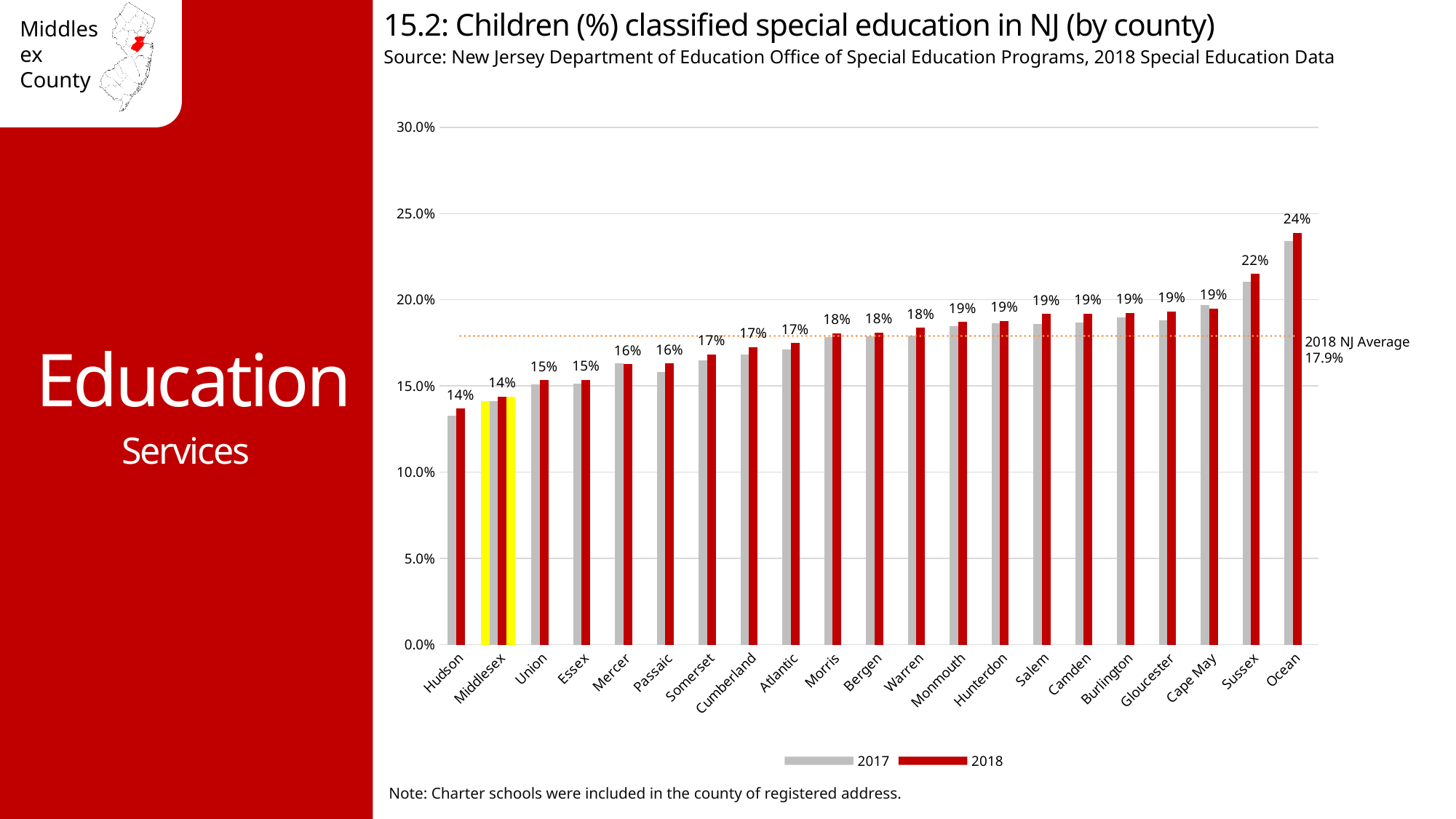
Which has the larger 2018 value, Sussex or Cape May? Sussex Is the 2017 value for Ocean greater or less than 20.0%? greater What is the 2018 value for Ocean county? 24% What kind of chart is shown? Bar chart What is the difference between the 2018 values for Ocean and Hudson? 10 percentage points Which county has the highest 2018 value? Ocean What is the 2018 value for Sussex county? 22% How many counties are shown on the x axis? 21 How many series does the legend list? 2 Is the 2017 value for Hudson greater or less than 15.0%? less What is the 2018 NJ average shown by the dotted line? 17.9% What is the 2018 value for Middlesex county? 14%